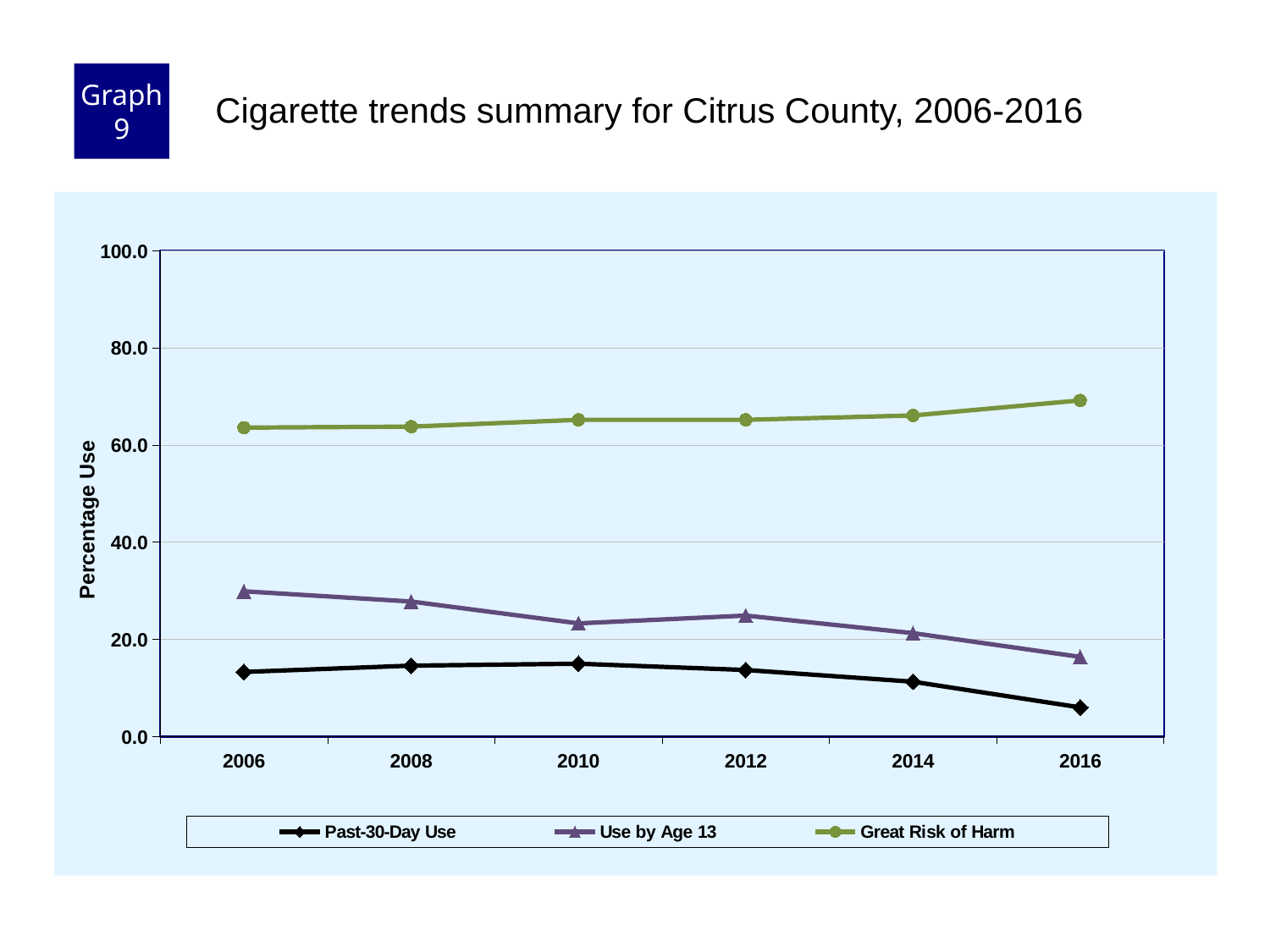
Which series has the highest values across all years? Great Risk of Harm What kind of chart is shown on the slide? Line chart Which series has the lowest values across all years? Past-30-Day Use In which year is Great Risk of Harm at its highest? 2016 Is the value for Great Risk of Harm in 2006 greater or less than 60.0? greater What is the label on the y axis? Percentage Use Does Use by Age 13 rise or fall overall from 2006 to 2016? Fall In which year is Use by Age 13 at its lowest? 2016 Is the value for Past-30-Day Use in 2016 greater or less than 20.0? less How many series does the legend list? 3 How many years are plotted along the x axis? 6 Is the value for Use by Age 13 in 2006 greater or less than 20.0? greater